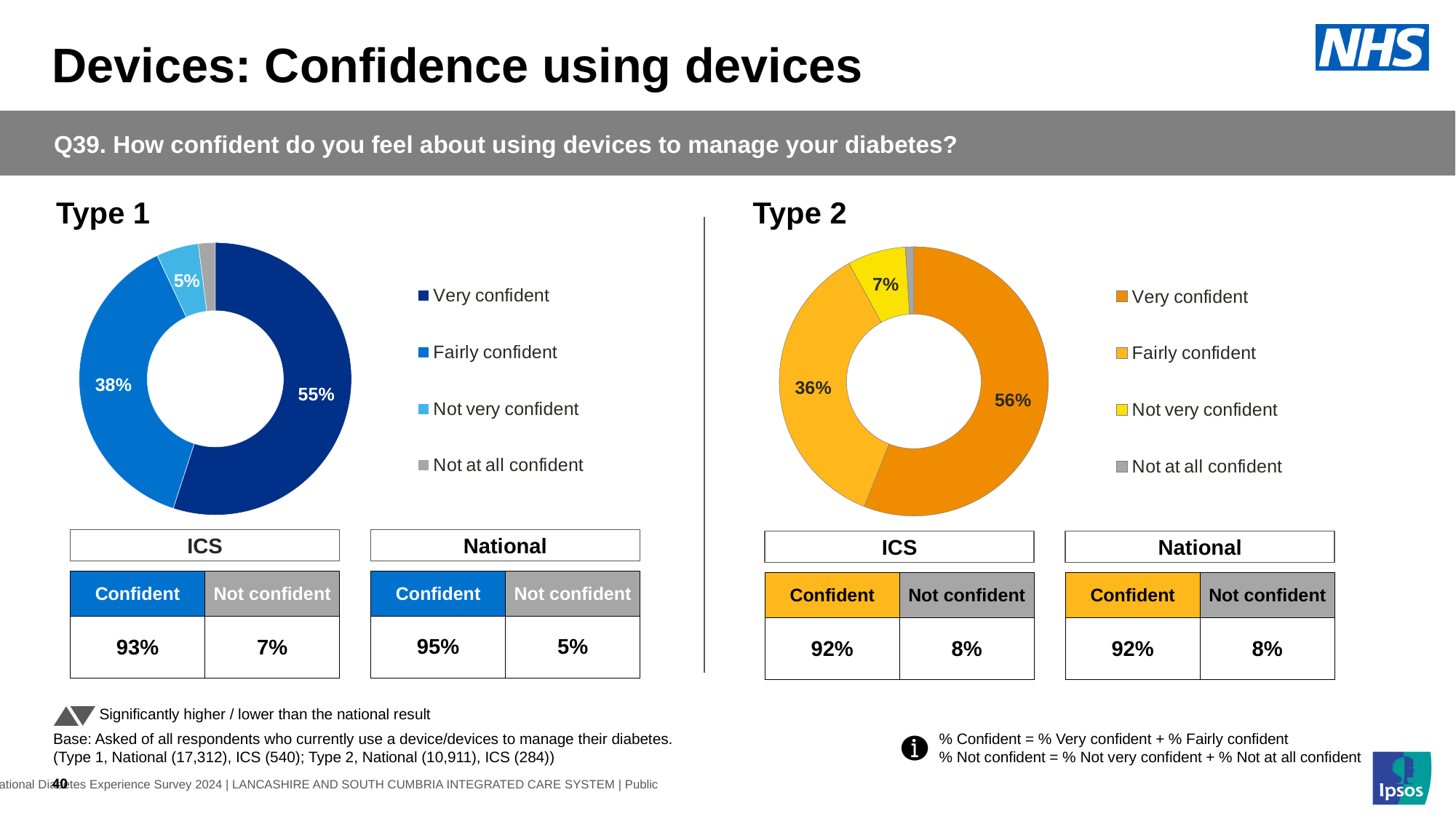
In the Type 1 chart, what percentage of respondents are very confident? 55% How many categories does the legend of the Type 1 chart list? 4 In the Type 2 chart, what is the difference between the very confident and not very confident shares? 49 percentage points In the Type 1 chart, what percentage of respondents are fairly confident? 38% In the Type 2 chart, which category has the largest share? Very confident In the Type 1 chart, what is the difference between the very confident and fairly confident shares? 17 percentage points In the Type 2 chart, what colour represents the 'Not very confident' category? Yellow What kind of chart is used for Type 2? Donut chart In the Type 2 chart, what percentage of respondents are not very confident? 7% In the Type 1 chart, which category has the smallest share? Not at all confident In the Type 2 chart, what percentage of respondents are fairly confident? 36% Which is larger: the very confident share in the Type 1 chart or the very confident share in the Type 2 chart? Type 2